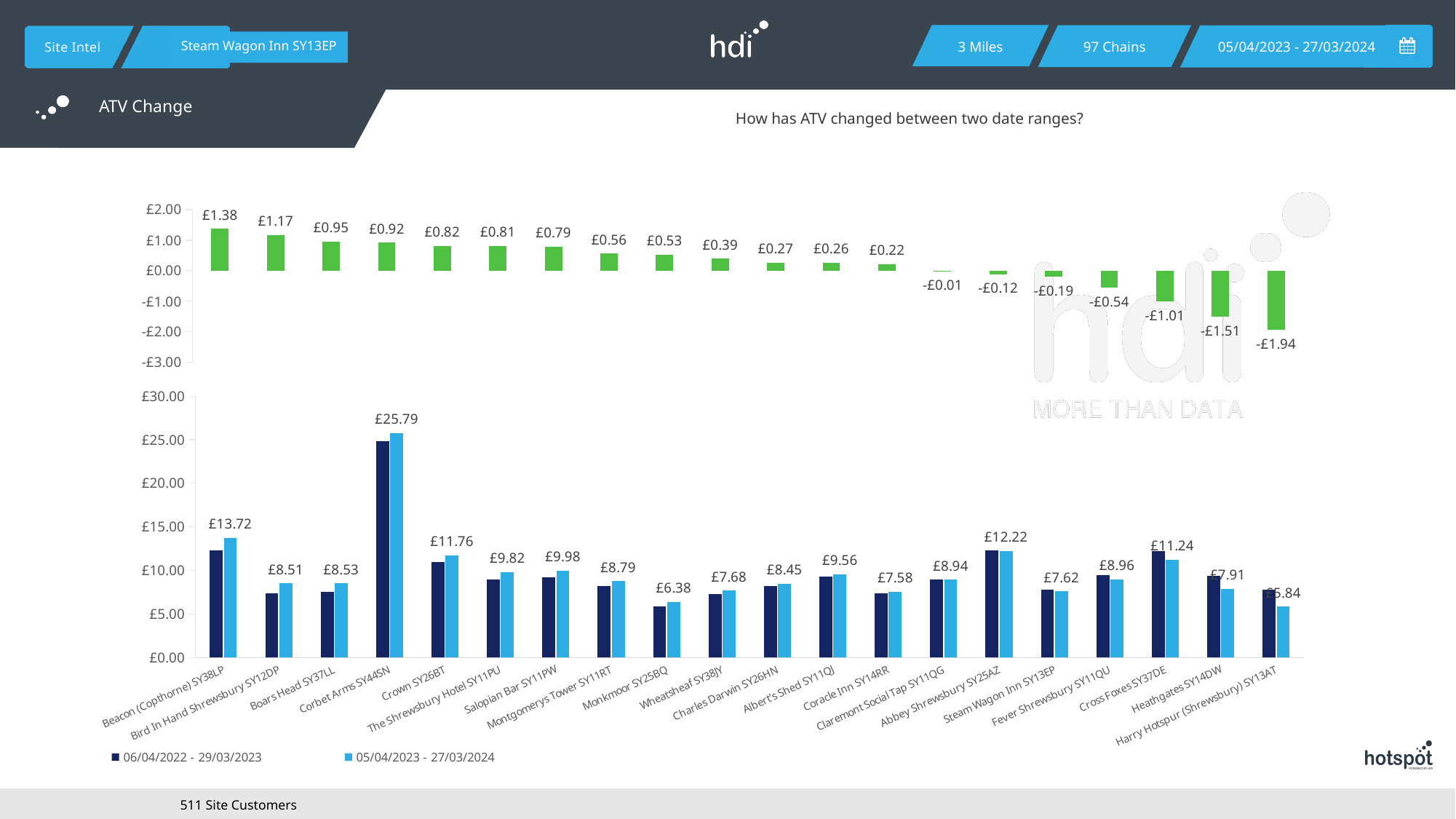
How many series does the legend of the lower chart list? 2 In the upper chart, what is the value of the lowest bar? -£1.94 In the upper chart, what is the value of the highest bar? £1.38 In the lower chart, which category has the highest value? Corbet Arms SY44SN How many categories are shown on the x axis of the lower chart? 20 In the upper chart, do the values rise or fall from left to right? fall In the lower chart, what is the labelled value for Corbet Arms SY44SN? £25.79 What kind of chart is the lower chart on the slide? bar chart In the lower chart, is the labelled value for Abbey Shrewsbury SY25AZ or Steam Wagon Inn SY13EP larger? Abbey Shrewsbury SY25AZ In the lower chart, is the 06/04/2022 - 29/03/2023 value for Cross Foxes SY37DE greater or less than £10.00? greater In the lower chart, what is the difference between the labelled values for Corbet Arms SY44SN and Beacon (Copthorne) SY38LP? £12.07 In the lower chart, which category has the lowest labelled value? Harry Hotspur (Shrewsbury) SY13AT